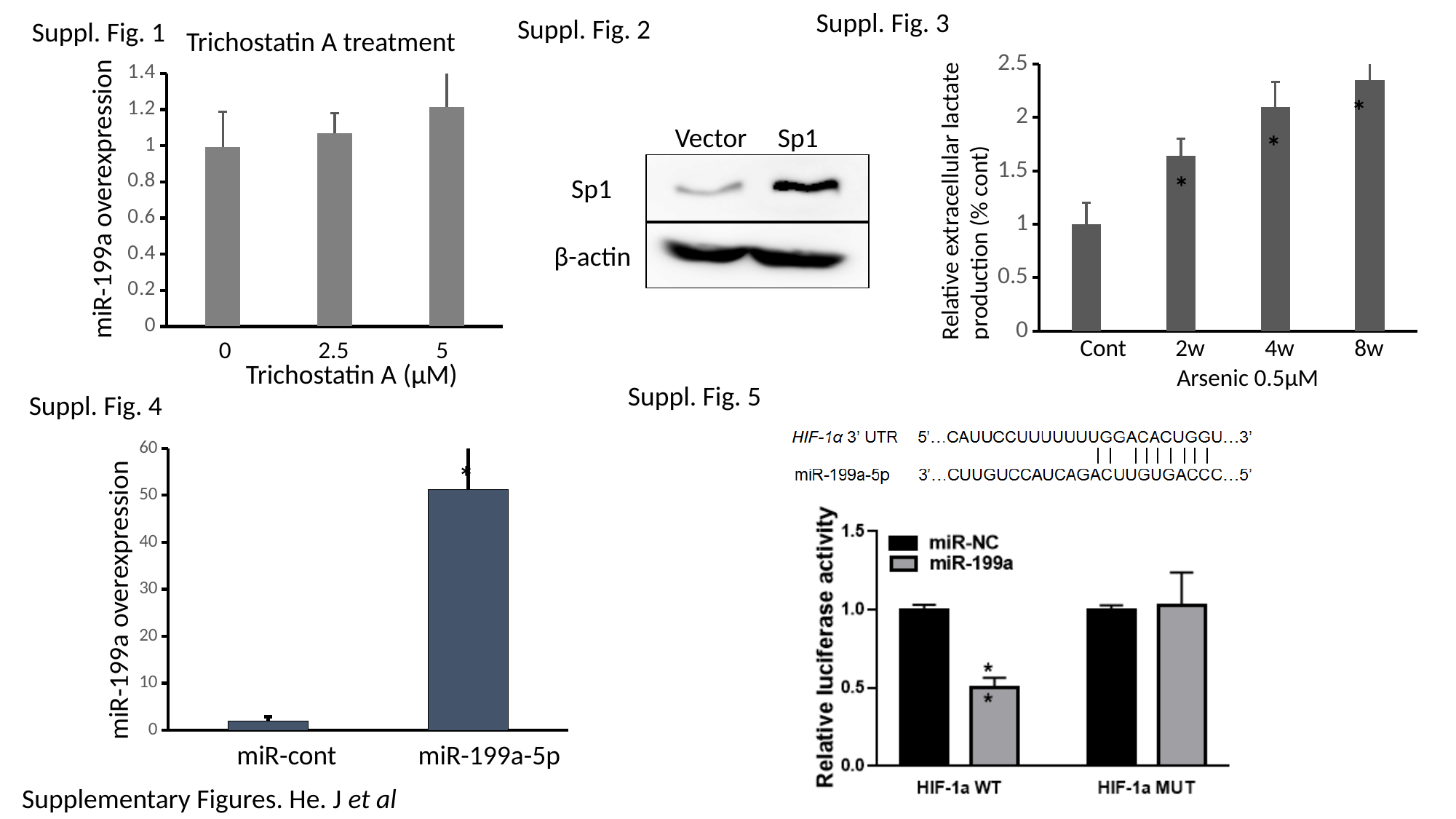
In Suppl. Fig. 5 (Relative luciferase activity), how many series does the legend list? 2 In Suppl. Fig. 5 (Relative luciferase activity), is the miR-199a value for HIF-1a WT greater or less than 1.0? less In Suppl. Fig. 1 (Trichostatin A treatment), is the value for 0 µM greater or less than 0.8? greater In Suppl. Fig. 3 (Arsenic 0.5µM), which category has the lowest relative extracellular lactate production? Cont In Suppl. Fig. 4, is the value for miR-cont greater or less than 10? less In Suppl. Fig. 3 (Arsenic 0.5µM), do the values rise or fall from Cont to 8w? rise In Suppl. Fig. 1 (Trichostatin A treatment), how many Trichostatin A concentrations are plotted on the x axis? 3 In Suppl. Fig. 3 (Arsenic 0.5µM), how many categories are shown on the x axis? 4 In Suppl. Fig. 4, which is larger, the value for miR-cont or for miR-199a-5p? miR-199a-5p In Suppl. Fig. 1 (Trichostatin A treatment), which Trichostatin A concentration has the highest miR-199a overexpression? 5 What kind of chart is Suppl. Fig. 1 (Trichostatin A treatment)? bar chart